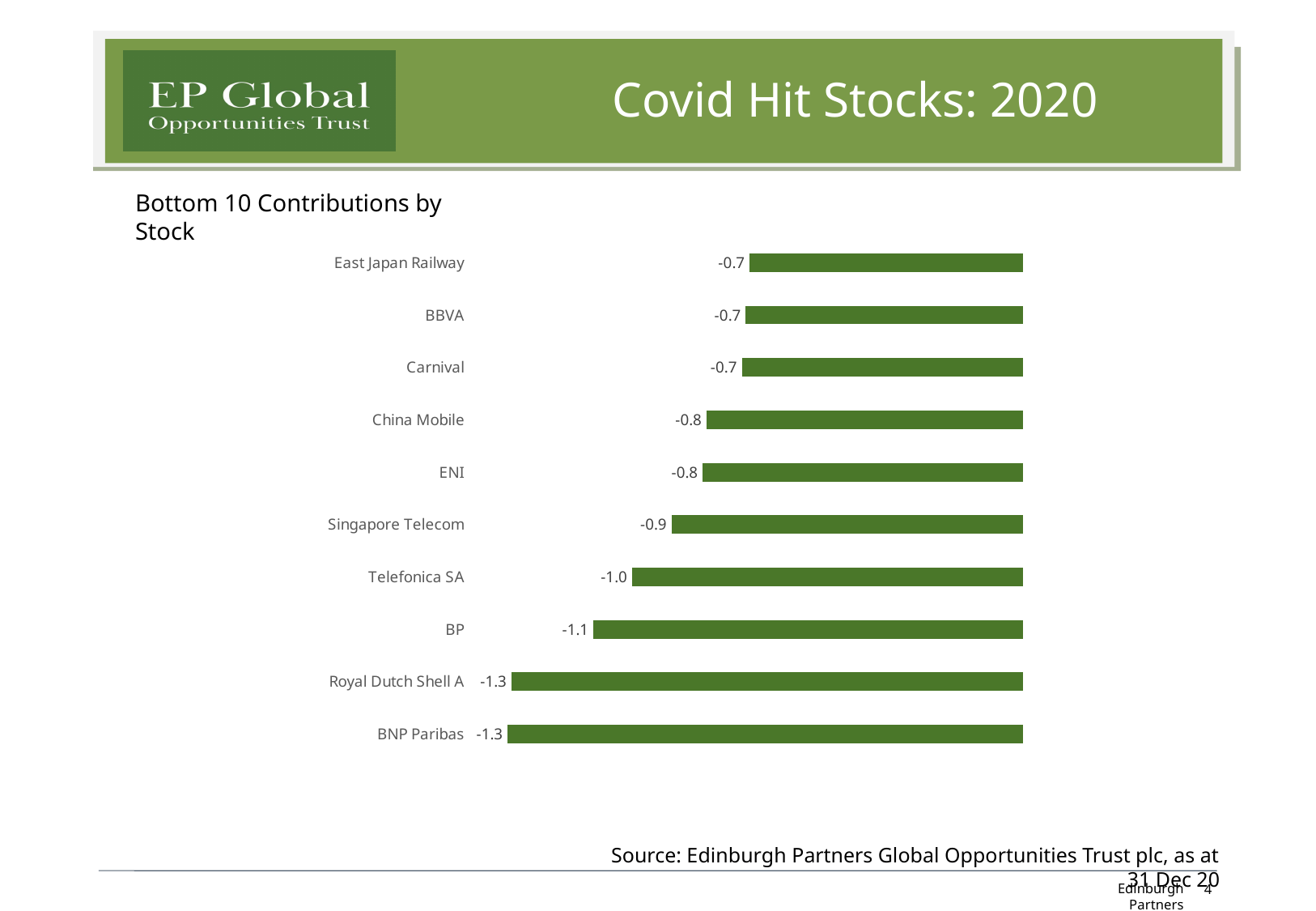
What is the contribution value shown for East Japan Railway? -0.7 What is the contribution value shown for China Mobile? -0.8 What is the difference between the values for BP and Singapore Telecom? 0.2 Which has the more negative contribution, BP or Telefonica SA? BP What is the title of the chart? Bottom 10 Contributions by Stock What kind of chart is shown on the slide? Bar chart How many stocks are shown in the chart? 10 What is the contribution value shown for Singapore Telecom? -0.9 What is the contribution value shown for Royal Dutch Shell A? -1.3 What is the contribution value shown for Telefonica SA? -1.0 What is the contribution value shown for BP? -1.1 What is the difference between the values for BNP Paribas and Carnival? 0.6